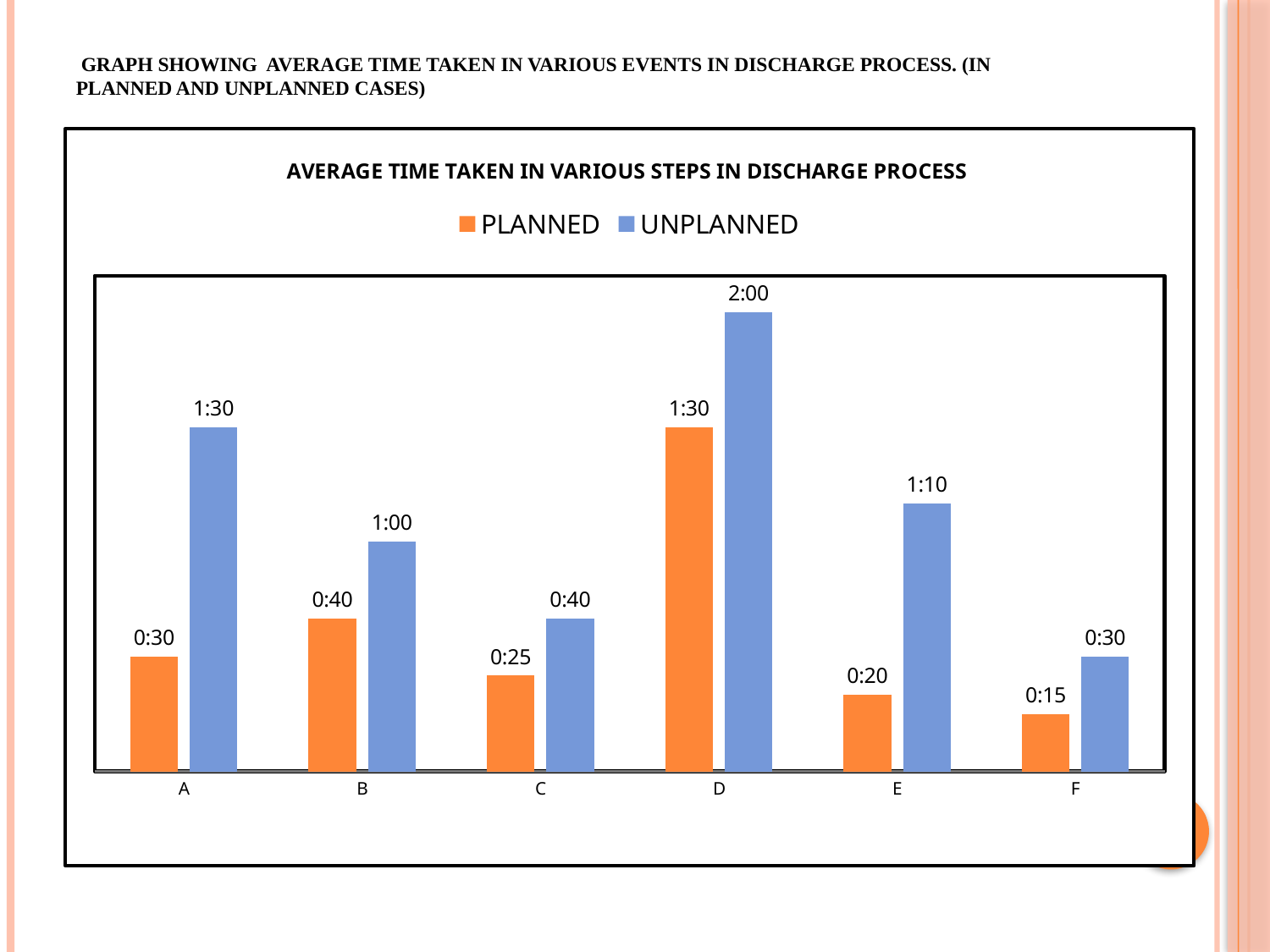
Which category has the highest UNPLANNED value? D What is the UNPLANNED value for category E? 1:10 Which category has the lowest UNPLANNED value? F What kind of chart is shown on the slide? Bar chart What is the PLANNED value for category F? 0:15 What is the PLANNED value for category D? 1:30 Which category has the lowest PLANNED value? F How many series does the legend list? 2 How many categories are shown on the x axis? 6 Which is larger for category A: the PLANNED value or the UNPLANNED value? UNPLANNED What is the title of the chart? AVERAGE TIME TAKEN IN VARIOUS STEPS IN DISCHARGE PROCESS What is the UNPLANNED value for category B? 1:00